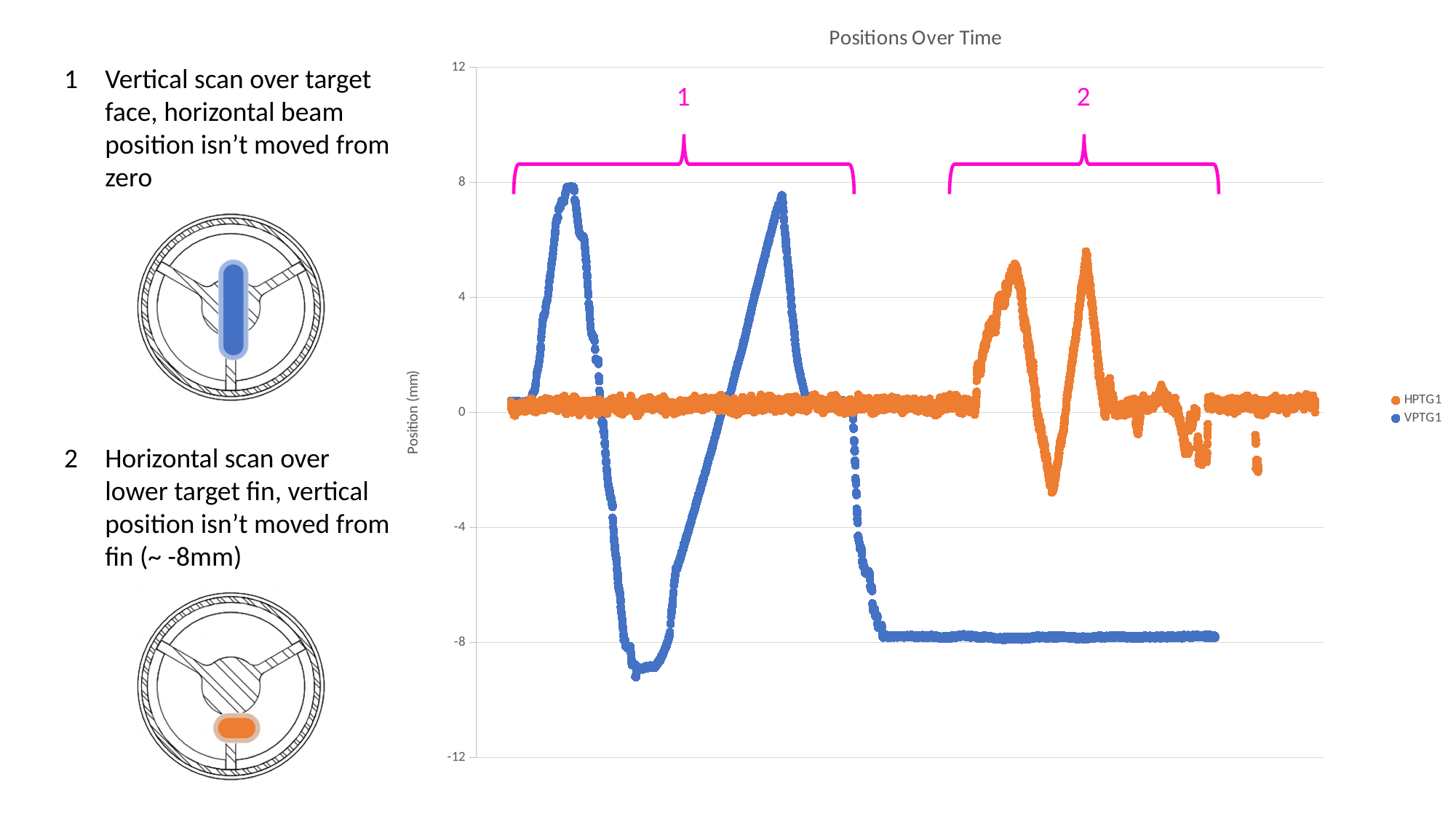
Which series reaches the lowest position value on the chart, HPTG1 or VPTG1? VPTG1 What kind of chart is shown on the slide? scatter chart Is the highest value reached by VPTG1 greater or less than 4? greater Is the lowest value reached by VPTG1 greater or less than -8? less In the region labelled 2, is the VPTG1 value greater or less than -4? less What is the label on the vertical axis of the chart? Position (mm) How many series does the chart legend list? 2 Which series reaches the highest position value on the chart, HPTG1 or VPTG1? VPTG1 Which series has the larger peak value, HPTG1 or VPTG1? VPTG1 What is the title of the chart? Positions Over Time